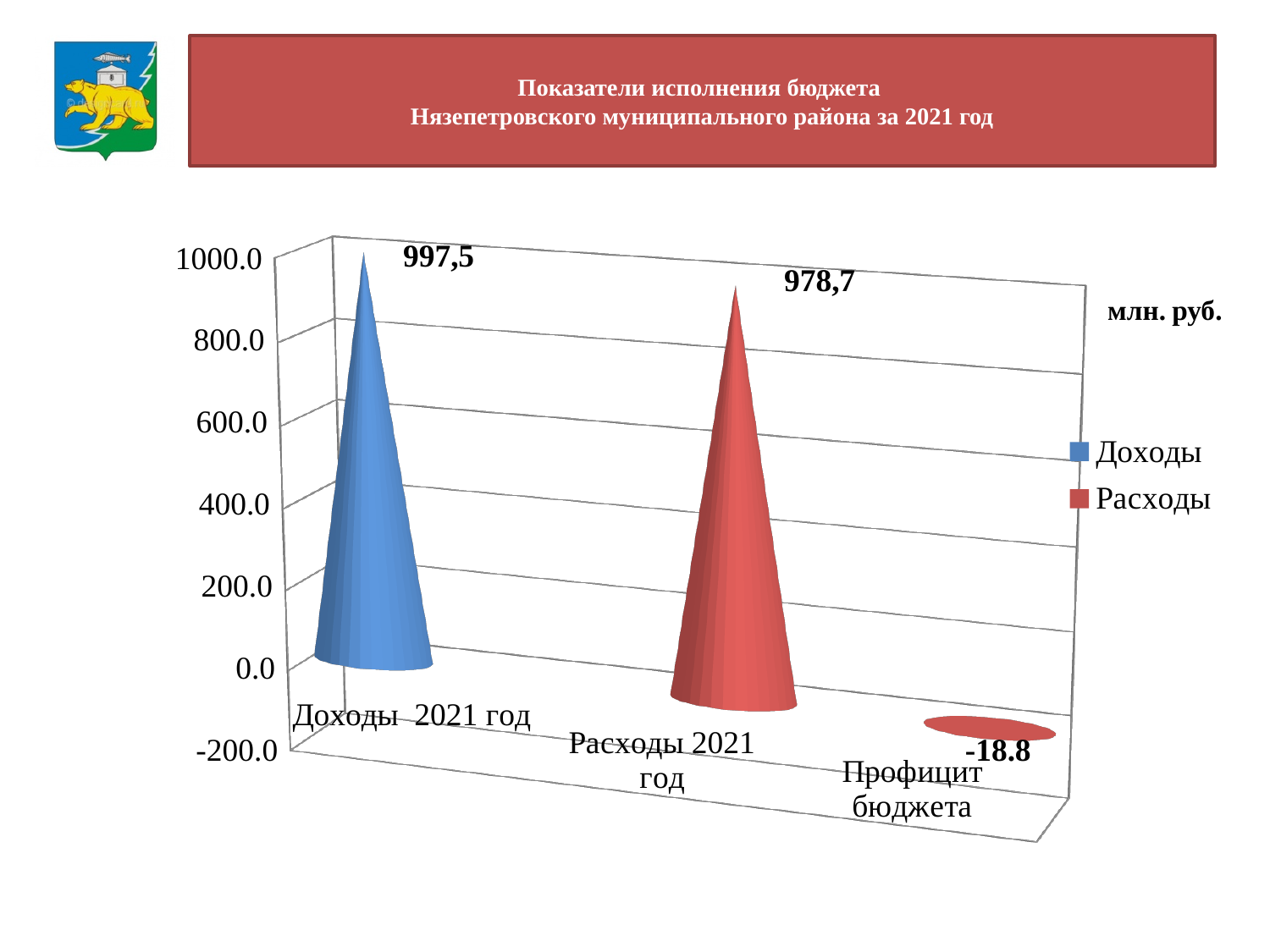
Which category has the lowest value? Профицит бюджета How many categories are plotted on the chart? 3 What unit of measurement is indicated next to the chart? млн. руб. Which is larger, Доходы 2021 год or Расходы 2021 год? Доходы 2021 год Which category has the highest value? Доходы 2021 год What is the value shown for Доходы 2021 год? 997,5 What kind of chart is shown on the slide? bar chart Is the value for Расходы 2021 год greater or less than 800.0? greater What is the difference between Доходы 2021 год and Расходы 2021 год? 18,8 What is the value shown for Профицит бюджета? -18.8 How many series does the legend list? 2 What is the value shown for Расходы 2021 год? 978,7